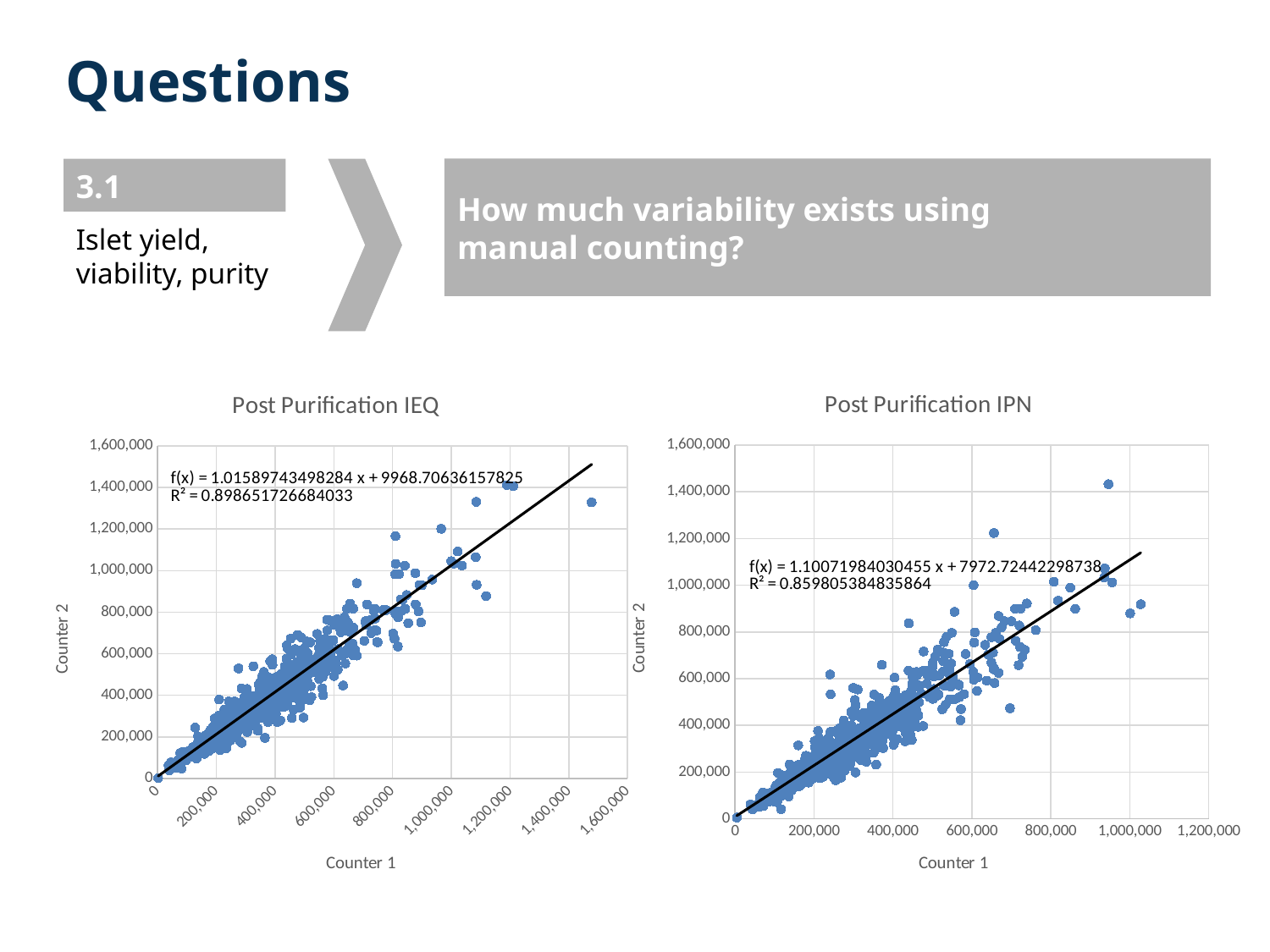
What kind of chart is the 'Post Purification IPN' chart? scatter chart What is the label of the y axis on the 'Post Purification IPN' chart? Counter 2 Which chart has the higher R² value, 'Post Purification IEQ' or 'Post Purification IPN'? Post Purification IEQ In the 'Post Purification IPN' chart, is the Counter 2 value of the highest point greater or less than 1,200,000? greater What kind of chart is the 'Post Purification IEQ' chart? scatter chart In the 'Post Purification IPN' chart, what is the R² value shown for the trendline? 0.859805384835864 What is the label of the x axis on the 'Post Purification IEQ' chart? Counter 1 In the 'Post Purification IEQ' chart, what is the trendline equation shown? f(x) = 1.01589743498284 x + 9968.70636157825 In the 'Post Purification IPN' chart, what is the trendline equation shown? f(x) = 1.10071984030455 x + 7972.72442298738 In the 'Post Purification IEQ' chart, do the Counter 2 values generally rise or fall as Counter 1 increases? rise Which chart's trendline has the larger slope, 'Post Purification IEQ' or 'Post Purification IPN'? Post Purification IPN In the 'Post Purification IEQ' chart, what is the R² value shown for the trendline? 0.898651726684033